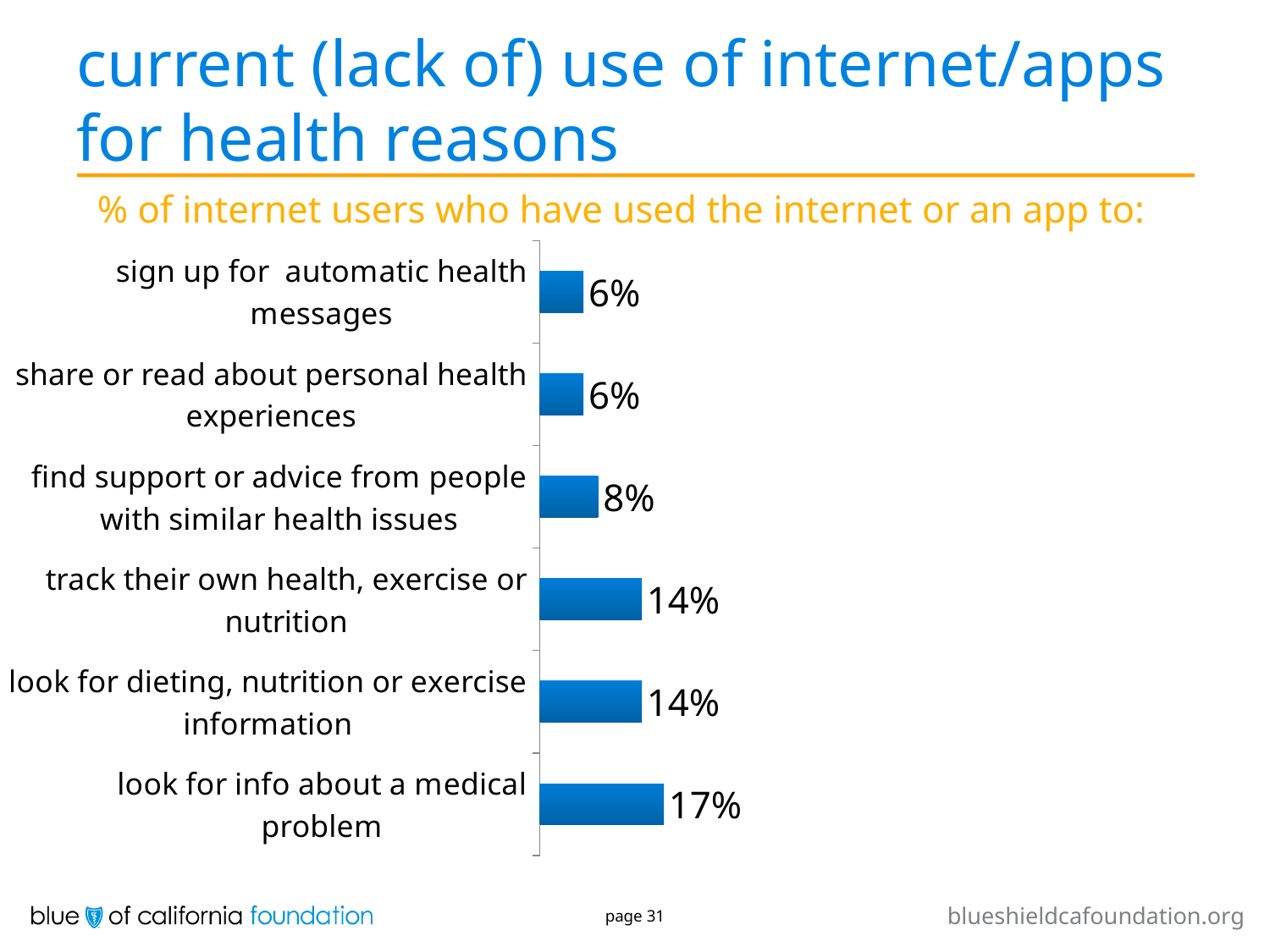
What is the difference in percentage points between tracking their own health, exercise or nutrition and sharing or reading about personal health experiences? 8 What is the subtitle shown above the chart? % of internet users who have used the internet or an app to: What is the difference in percentage points between looking for info about a medical problem and finding support or advice from people with similar health issues? 9 What kind of chart is shown on the slide? bar chart What colour are the bars in the chart? blue What percentage of internet users have used the internet or an app to look for info about a medical problem? 17% Which activity has the highest percentage of internet users? look for info about a medical problem Which is larger: the percentage for looking for dieting, nutrition or exercise information or the percentage for finding support or advice from people with similar health issues? look for dieting, nutrition or exercise information What percentage of internet users have used the internet or an app to sign up for automatic health messages? 6% How many activities (categories) are shown in the chart? 6 What percentage of internet users have used the internet or an app to track their own health, exercise or nutrition? 14% What percentage of internet users have used the internet or an app to find support or advice from people with similar health issues? 8%